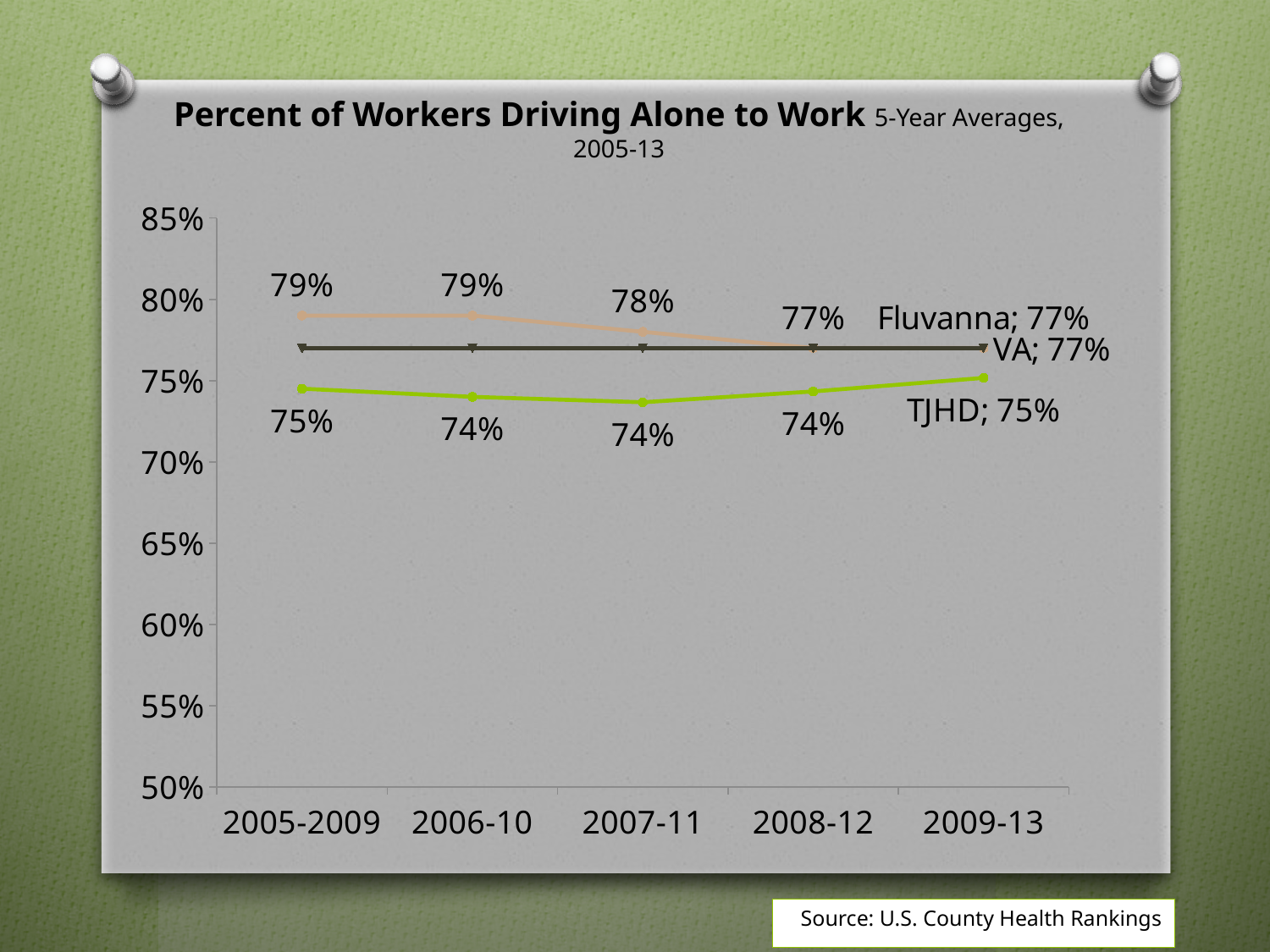
What is the difference between the Fluvanna and TJHD values for 2005-2009? 4% What is the VA value for 2009-13? 77% In which period is the Fluvanna value lowest? 2008-12 and 2009-13 What type of chart is shown on the slide? line chart What is the Fluvanna value for 2009-13? 77% How many periods are shown on the x axis? 5 What is the TJHD value for 2007-11? 74% Does the Fluvanna line rise or fall from 2005-2009 to 2009-13? fall What is the TJHD value for 2009-13? 75% What is the Fluvanna value for 2005-2009? 79% How many series are plotted on the chart? 3 Which is larger for 2007-11, the Fluvanna value or the TJHD value? Fluvanna